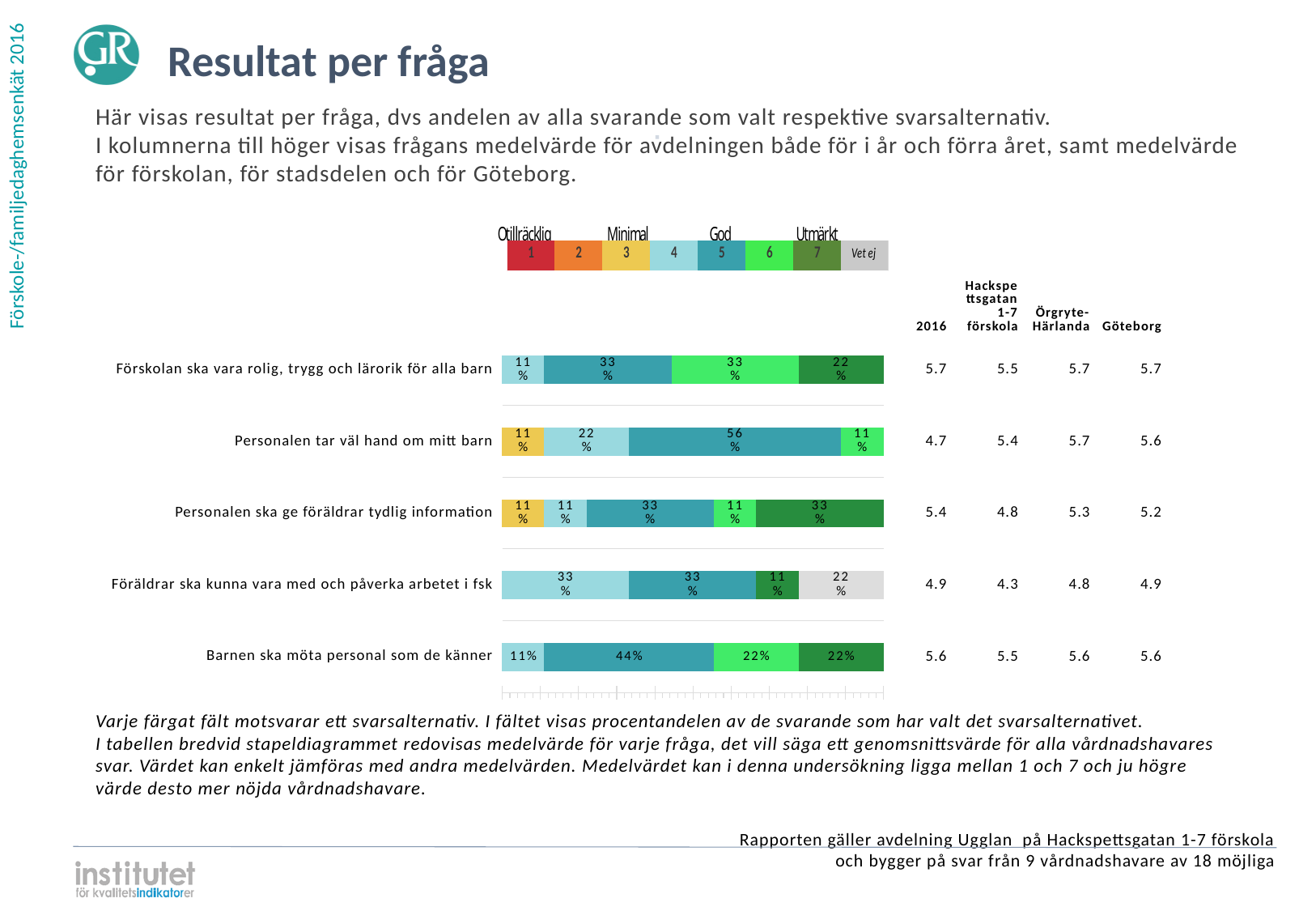
For 'Barnen ska möta personal som de känner', which is larger: the share choosing answer 5 or the share choosing answer 6? Answer 5 For 'Förskolan ska vara rolig, trygg och lärorik för alla barn', what is the difference between the share choosing answer 5 and the share choosing answer 7? 11% What kind of chart is shown on the slide? Stacked bar chart Which question is the only one with a grey 'Vet ej' segment in its bar? Föräldrar ska kunna vara med och påverka arbetet i fsk What percentage of respondents chose answer 7 for 'Personalen ska ge föräldrar tydlig information'? 33% What percentage of respondents answered 'Vet ej' for 'Föräldrar ska kunna vara med och påverka arbetet i fsk'? 22% How many answer alternatives does the legend above the chart list? 8 What is the 2016 mean value shown for 'Personalen tar väl hand om mitt barn'? 4.7 Which question has the largest single segment in its bar? Personalen tar väl hand om mitt barn How many questions (categories) are plotted in the bar chart? 5 What percentage of respondents chose answer 5 for 'Barnen ska möta personal som de känner'? 44% What percentage of respondents chose answer 5 for 'Personalen tar väl hand om mitt barn'? 56%